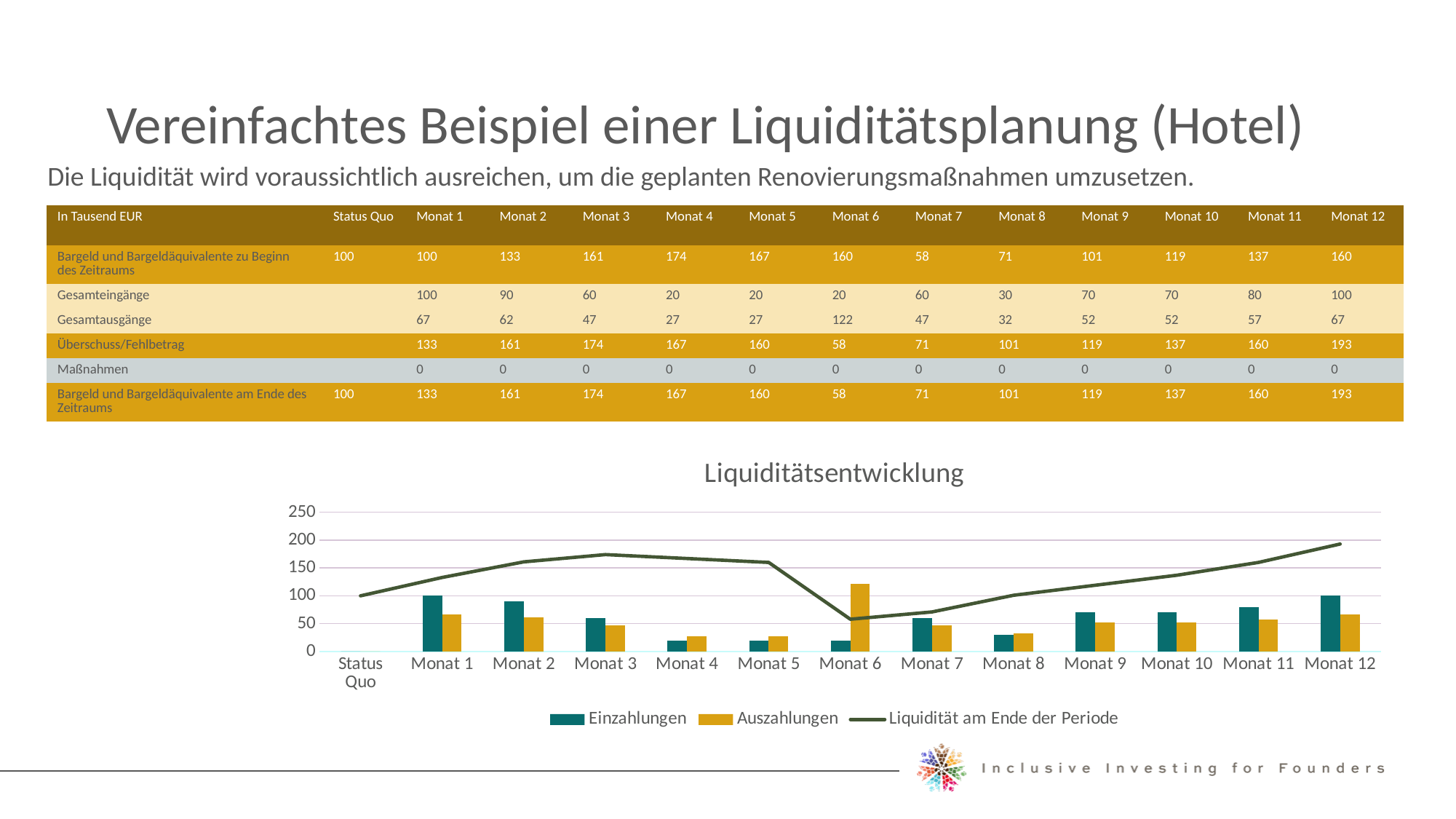
What is the title of the chart? Liquiditätsentwicklung How many categories are shown on the x axis of the chart? 13 What is the value of Einzahlungen for Monat 1? 100 Is the value of Auszahlungen for Monat 6 greater or less than 100? greater How many series does the chart legend list? 3 In which month is Auszahlungen highest? Monat 6 In Monat 6, which is larger: Einzahlungen or Auszahlungen? Auszahlungen In which month is Liquidität am Ende der Periode lowest? Monat 6 What kind of chart is shown on the slide? Bar chart with a line Is the value of Einzahlungen for Monat 4 greater or less than 50? less In which month is Liquidität am Ende der Periode highest? Monat 12 What is the value of Liquidität am Ende der Periode at Status Quo? 100